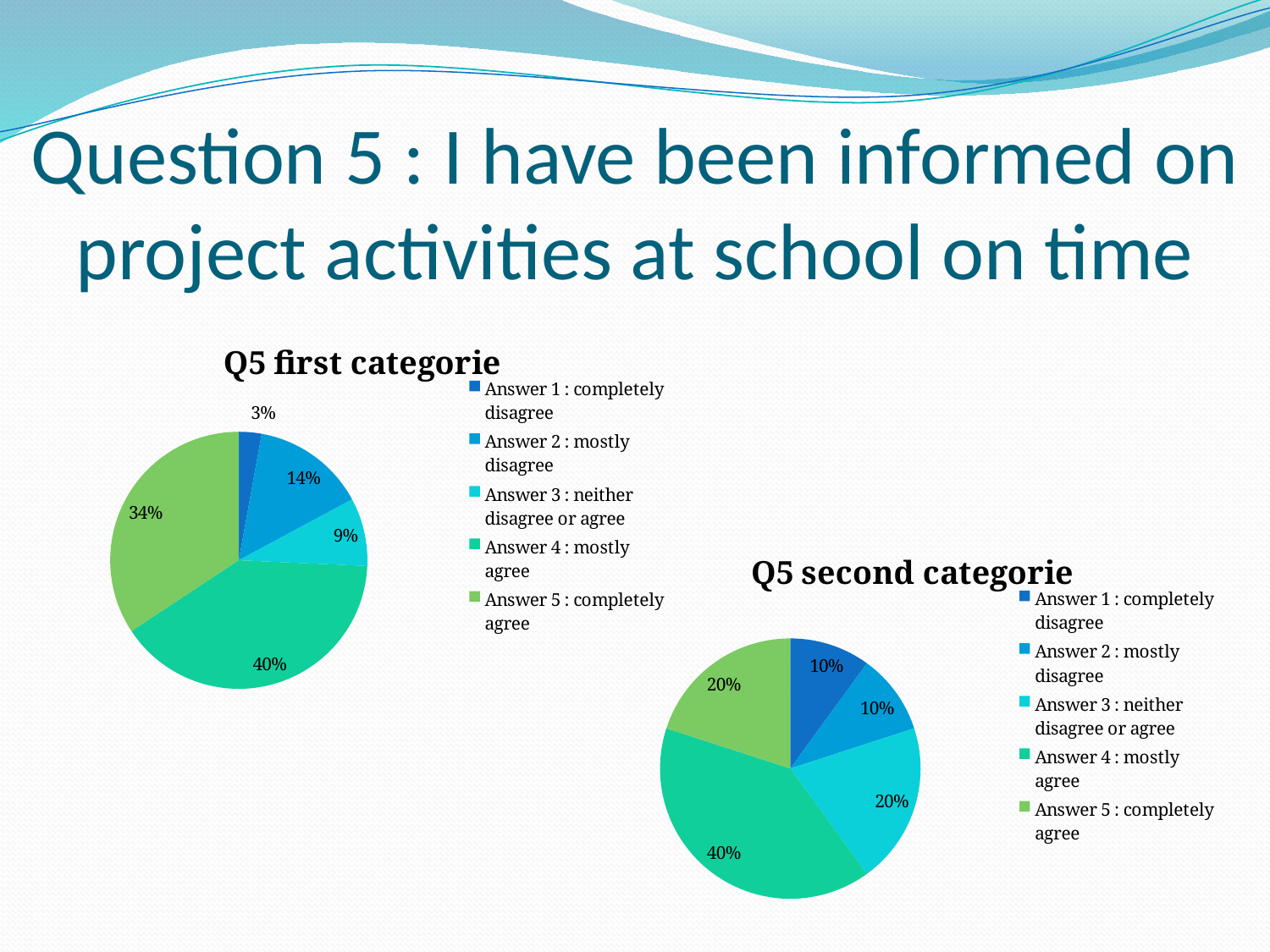
In the 'Q5 first categorie' chart, what share is labelled for Answer 4 : mostly agree? 40% What type of chart is 'Q5 first categorie'? pie chart In the 'Q5 first categorie' chart, which answer has the largest slice? Answer 4 : mostly agree In the 'Q5 second categorie' chart, what share is labelled for Answer 3 : neither disagree or agree? 20% In the 'Q5 first categorie' chart, what is the difference between the shares for Answer 4 : mostly agree and Answer 5 : completely agree? 6% How many slices does the 'Q5 second categorie' pie chart have? 5 In the 'Q5 second categorie' chart, which answer has the largest slice? Answer 4 : mostly agree In the 'Q5 first categorie' chart, what share is labelled for Answer 1 : completely disagree? 3% In the 'Q5 second categorie' chart, is the slice for Answer 5 : completely agree larger or smaller than the slice for Answer 1 : completely disagree? larger In the 'Q5 first categorie' chart, what share is labelled for Answer 2 : mostly disagree? 14% In the 'Q5 first categorie' chart, which answer has the smallest slice? Answer 1 : completely disagree In the 'Q5 second categorie' chart, what share is labelled for Answer 4 : mostly agree? 40%